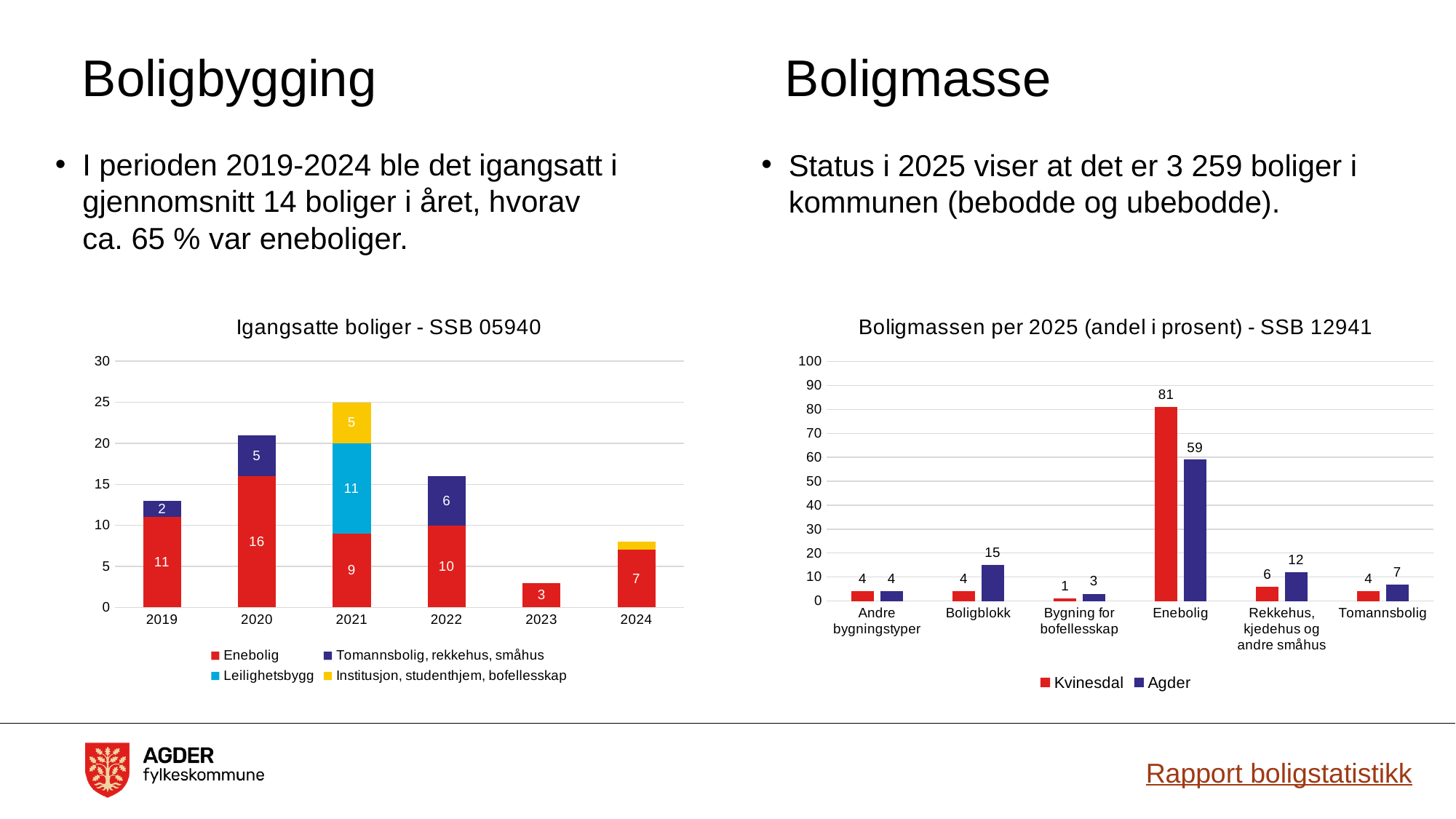
In the chart 'Igangsatte boliger - SSB 05940', what is the total of the stacked bar for 2019? 13 In the chart 'Igangsatte boliger - SSB 05940', which year has the lowest total of started dwellings? 2023 In the chart 'Igangsatte boliger - SSB 05940', what is the value for Leilighetsbygg in 2021? 11 In the chart 'Boligmassen per 2025 (andel i prosent) - SSB 12941', what is the value for Kvinesdal for Enebolig? 81 In the chart 'Boligmassen per 2025 (andel i prosent) - SSB 12941', how many categories are shown on the x axis? 6 In the chart 'Igangsatte boliger - SSB 05940', what is the difference between the Enebolig values for 2020 and 2022? 6 In the chart 'Boligmassen per 2025 (andel i prosent) - SSB 12941', what is the value for Agder for Boligblokk? 15 In the chart 'Boligmassen per 2025 (andel i prosent) - SSB 12941', which is larger for Rekkehus, kjedehus og andre småhus: Kvinesdal or Agder? Agder In the chart 'Igangsatte boliger - SSB 05940', what is the value for Enebolig in 2020? 16 In the chart 'Igangsatte boliger - SSB 05940', how many series does the legend list? 4 In the chart 'Boligmassen per 2025 (andel i prosent) - SSB 12941', what is the difference between Kvinesdal and Agder for Enebolig? 22 In the chart 'Igangsatte boliger - SSB 05940', what is the total of the stacked bar for 2021? 25